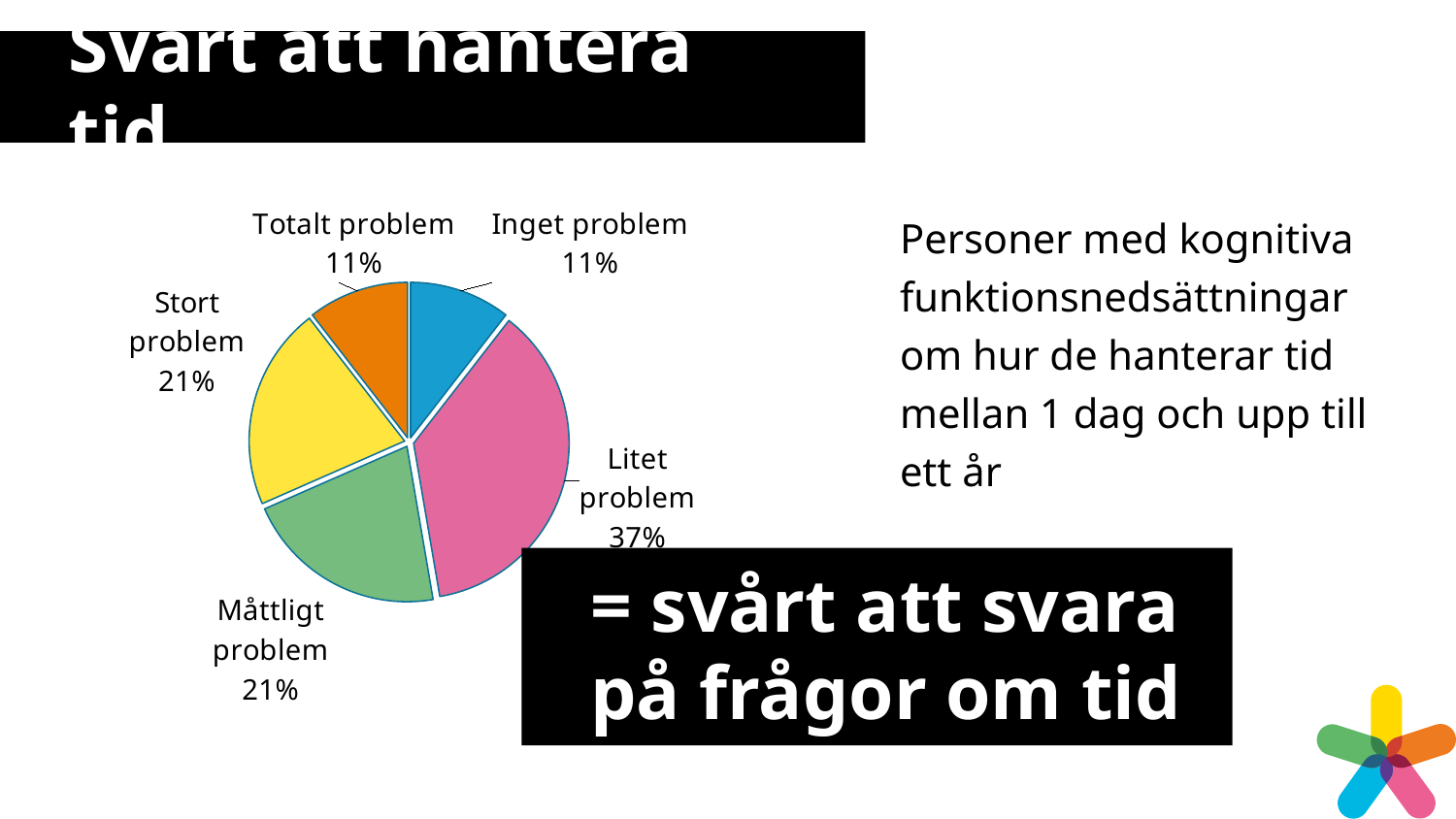
What percentage is shown for "Inget problem"? 11% What percentage is shown for "Stort problem"? 21% What colour is the "Litet problem" slice? pink How many slices does the pie chart have? 5 What is the combined percentage of "Måttligt problem" and "Stort problem"? 42% Which is larger, the slice for "Litet problem" or the slice for "Stort problem"? Litet problem What percentage is shown for "Totalt problem"? 11% Which category has the largest slice of the pie? Litet problem What is the difference in percentage points between "Litet problem" and "Måttligt problem"? 16 What percentage is shown for "Måttligt problem"? 21% What share of the pie is labelled "Litet problem"? 37% What kind of chart is shown on the slide? pie chart